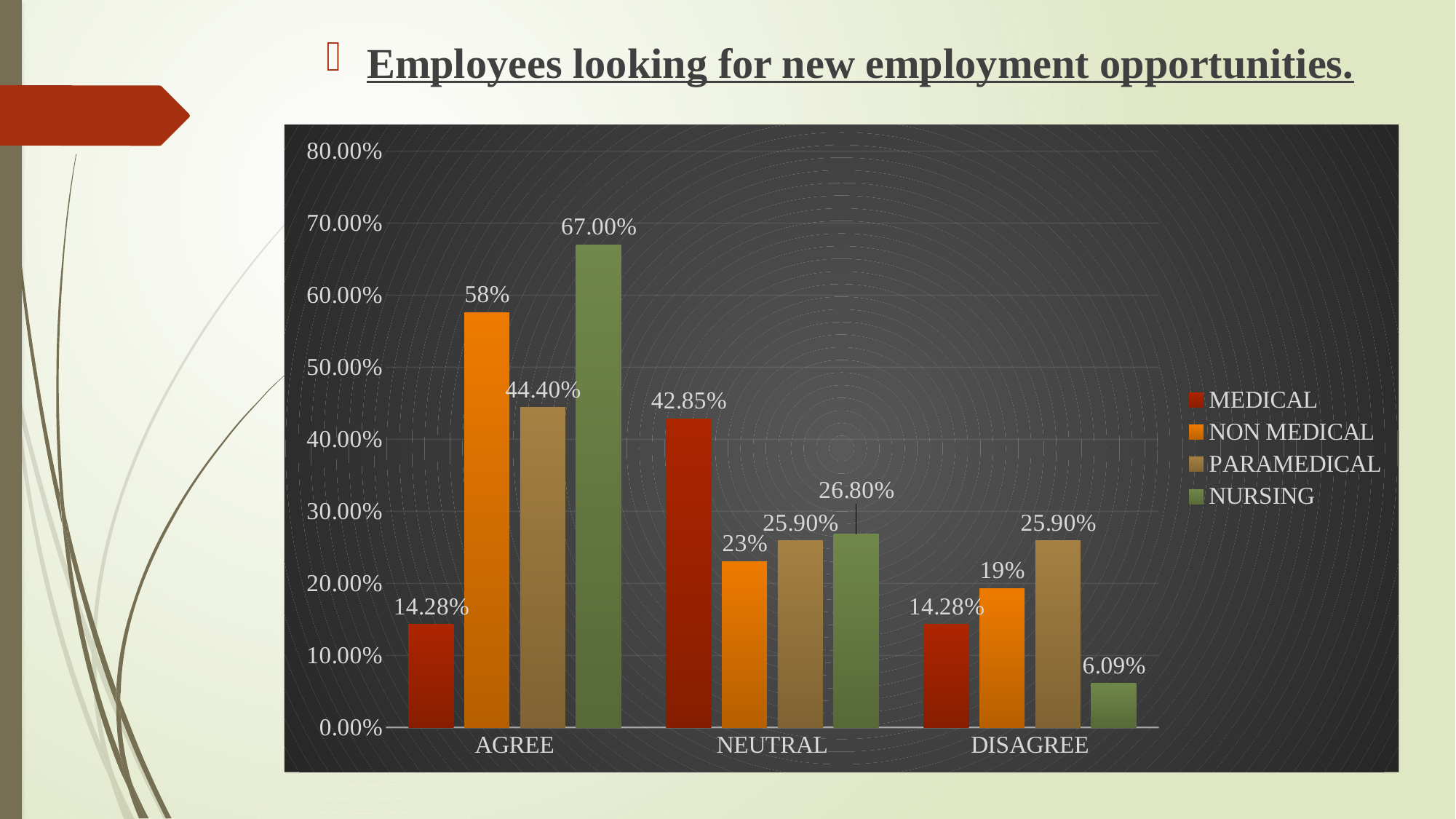
What is the value for NON MEDICAL in the AGREE category? 58% What is the value for MEDICAL in the NEUTRAL category? 42.85% What is the value for NURSING in the DISAGREE category? 6.09% What is the title of the slide above the chart? Employees looking for new employment opportunities. What kind of chart is shown on the slide? bar chart What is the difference between the NURSING and NON MEDICAL values in the AGREE category? 9% How many categories are shown on the x axis? 3 Which is larger: the MEDICAL value for NEUTRAL or the PARAMEDICAL value for AGREE? PARAMEDICAL value for AGREE Which series has the highest value in the AGREE category? NURSING Which series has the lowest value in the DISAGREE category? NURSING What is the value for NURSING in the AGREE category? 67.00% How many series does the legend list? 4